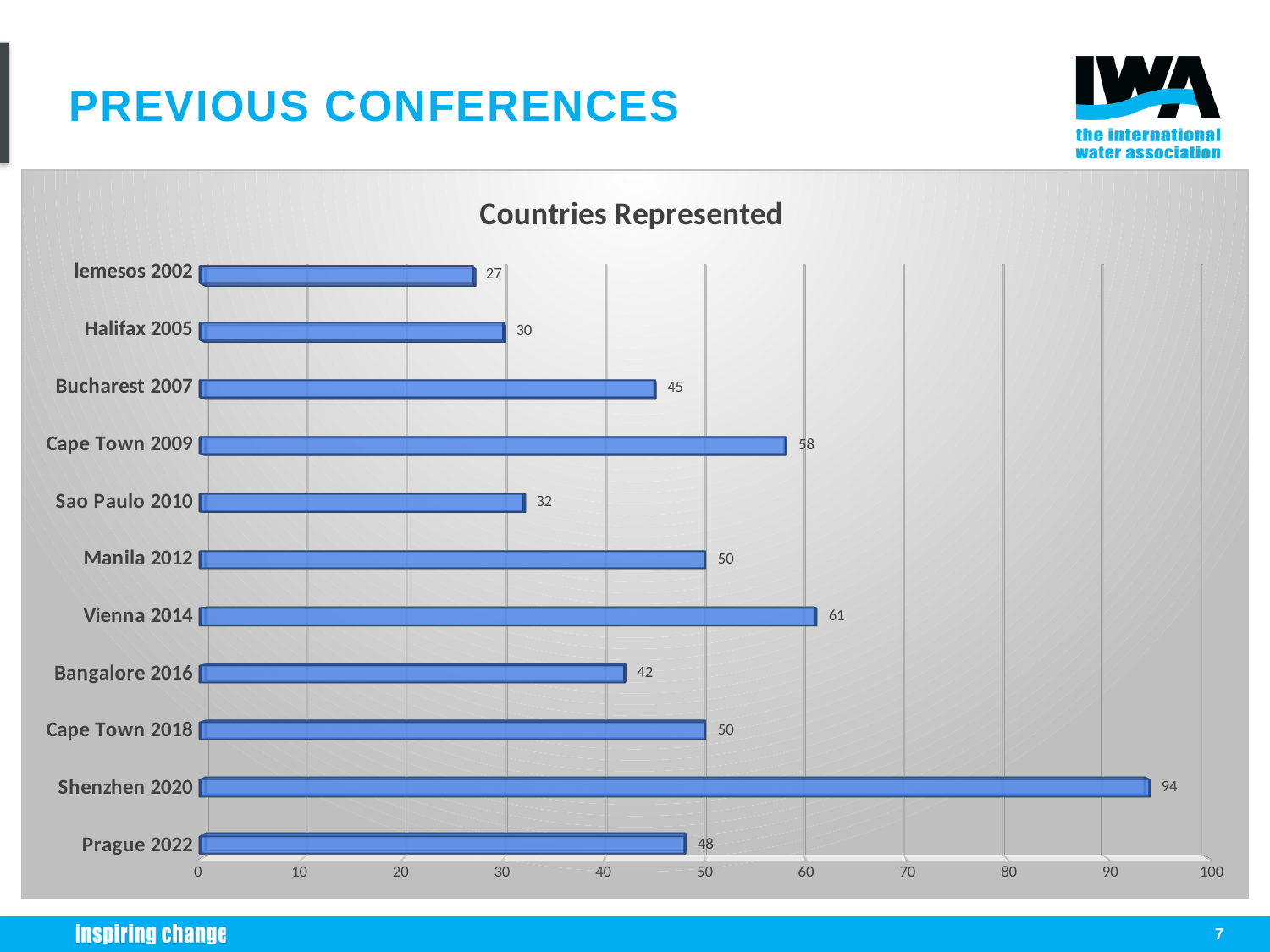
What kind of chart is shown on the slide? bar chart What is the value for Cape Town 2009? 58 What is the title of the chart? Countries Represented Is the value for Vienna 2014 greater or less than 60? greater What is the difference between the values for Shenzhen 2020 and Vienna 2014? 33 What is the value for Sao Paulo 2010? 32 What is the value for Shenzhen 2020? 94 Which is larger, the value for Bangalore 2016 or the value for Prague 2022? Prague 2022 Which conference has the highest number of countries represented? Shenzhen 2020 What is the difference between the values for Bucharest 2007 and Halifax 2005? 15 How many conferences are shown in the chart? 11 Which conference has the lowest number of countries represented? lemesos 2002